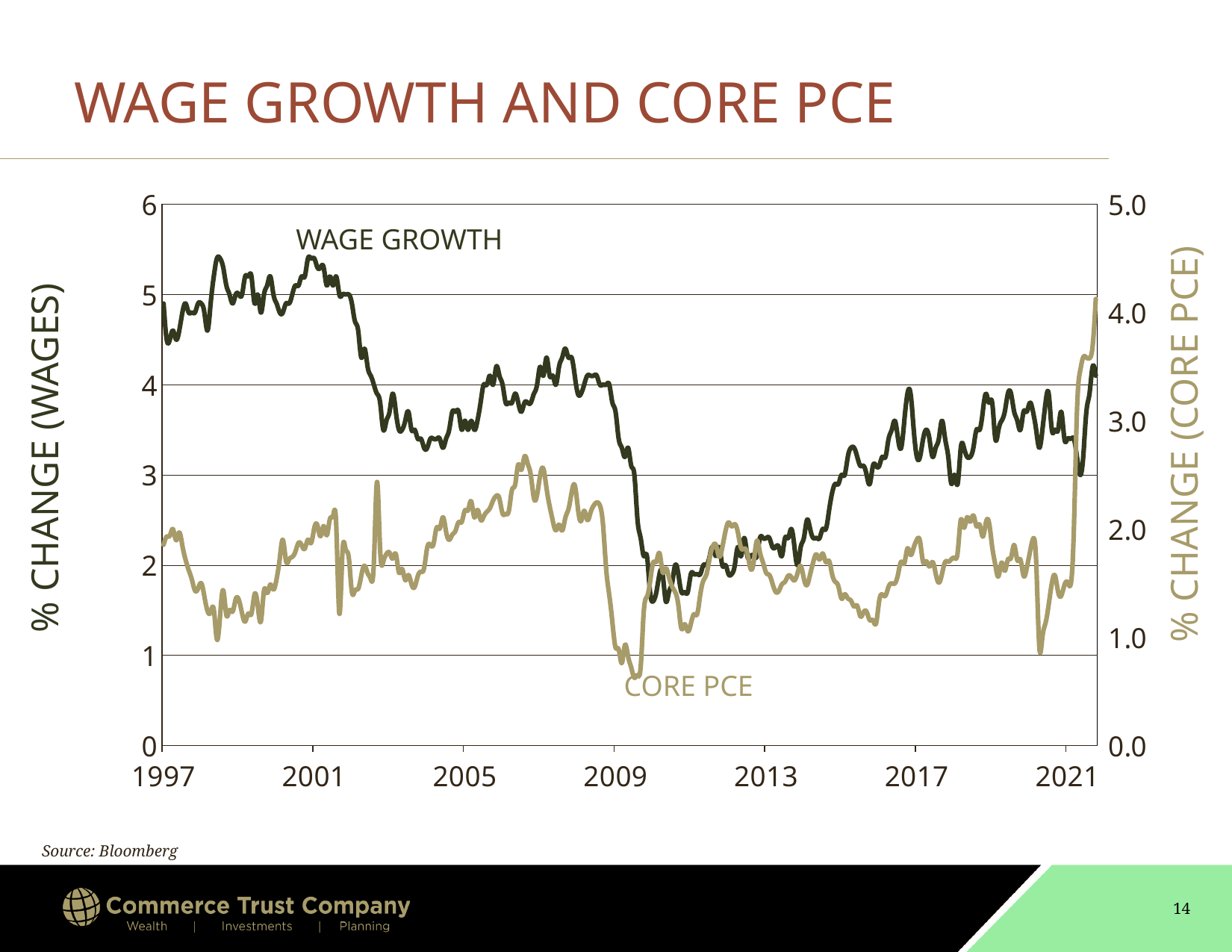
How many series are plotted on the chart? 2 Is the value for Wage Growth around 2001 greater or less than 5? greater Around which year does Core PCE reach its highest value on the chart? 2021 Is the value for Core PCE at its 2009 low greater or less than 1.0? less Is the value for Core PCE at the end of 2021 greater or less than 3.0? greater What is the title of the chart on the slide? WAGE GROWTH AND CORE PCE How many year labels are shown on the x axis? 7 Does Wage Growth rise or fall between 2001 and 2004? fall What is the label of the right-hand vertical axis? % CHANGE (CORE PCE) Around which year does Core PCE reach its lowest value on the chart? 2009 What kind of chart is shown on the slide? Line chart